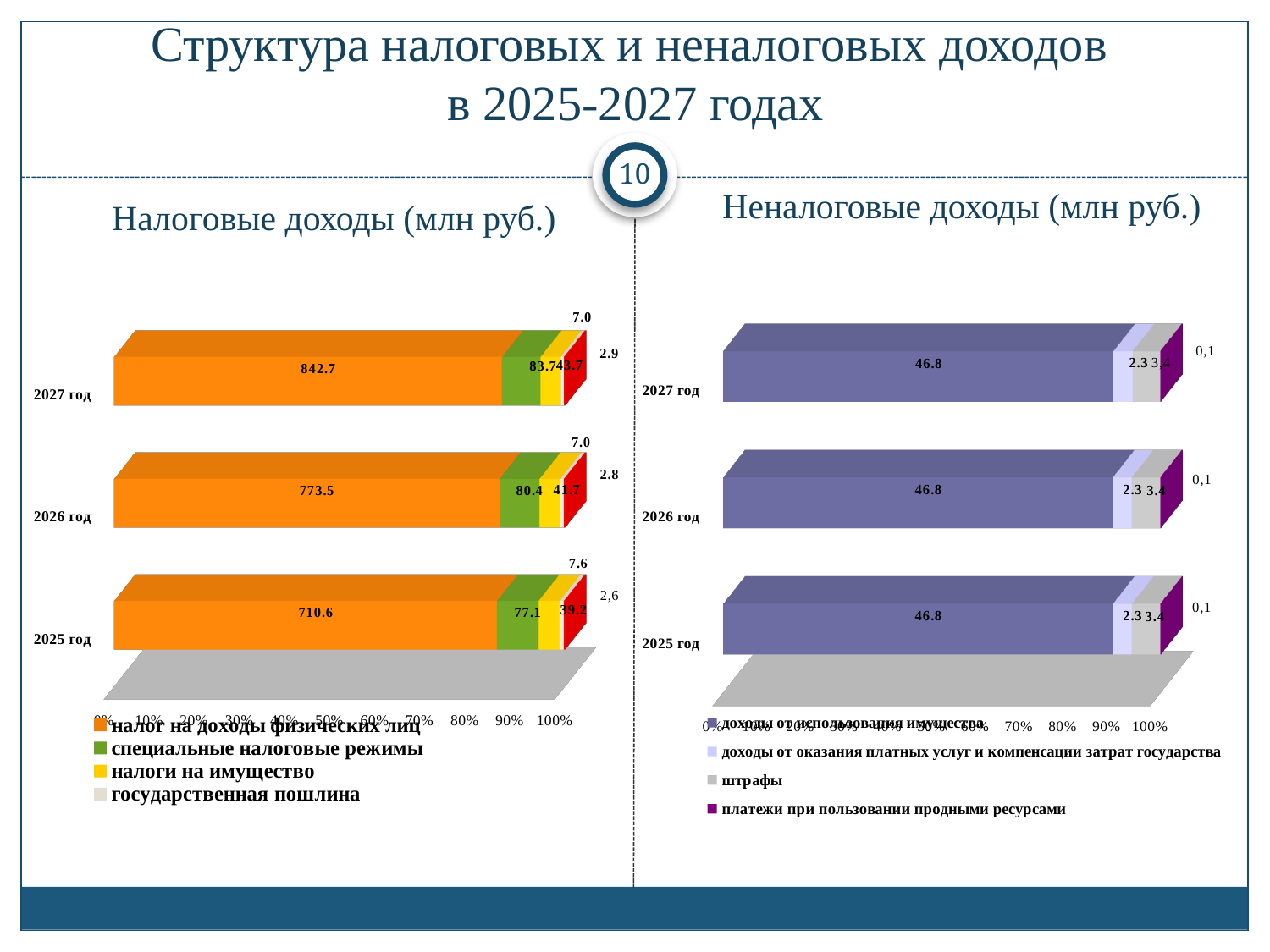
On the 'Налоговые доходы (млн руб.)' chart, what is the value of налог на доходы физических лиц for 2027 год? 842.7 On the 'Налоговые доходы (млн руб.)' chart, what is the value of налог на доходы физических лиц for 2025 год? 710.6 On the 'Налоговые доходы (млн руб.)' chart, does the value of налог на доходы физических лиц rise or fall from 2025 год to 2027 год? rise On the 'Налоговые доходы (млн руб.)' chart, by how much does налог на доходы физических лиц in 2027 год exceed that in 2025 год? 132.1 How many series does the legend of the 'Неналоговые доходы (млн руб.)' chart list? 4 On the 'Неналоговые доходы (млн руб.)' chart, what is the value of доходы от использования имущества for 2026 год? 46.8 On the 'Неналоговые доходы (млн руб.)' chart, which is larger for 2027 год: штрафы or доходы от оказания платных услуг и компенсации затрат государства? штрафы On the 'Налоговые доходы (млн руб.)' chart, what is the value of специальные налоговые режимы for 2026 год? 80.4 On the 'Налоговые доходы (млн руб.)' chart, what is the value of налоги на имущество for 2025 год? 39.2 What kind of chart is the 'Налоговые доходы (млн руб.)' chart? stacked bar chart On the 'Неналоговые доходы (млн руб.)' chart, what is the value of штрафы for 2025 год? 3.4 On the 'Налоговые доходы (млн руб.)' chart, which year has the highest value of специальные налоговые режимы? 2027 год